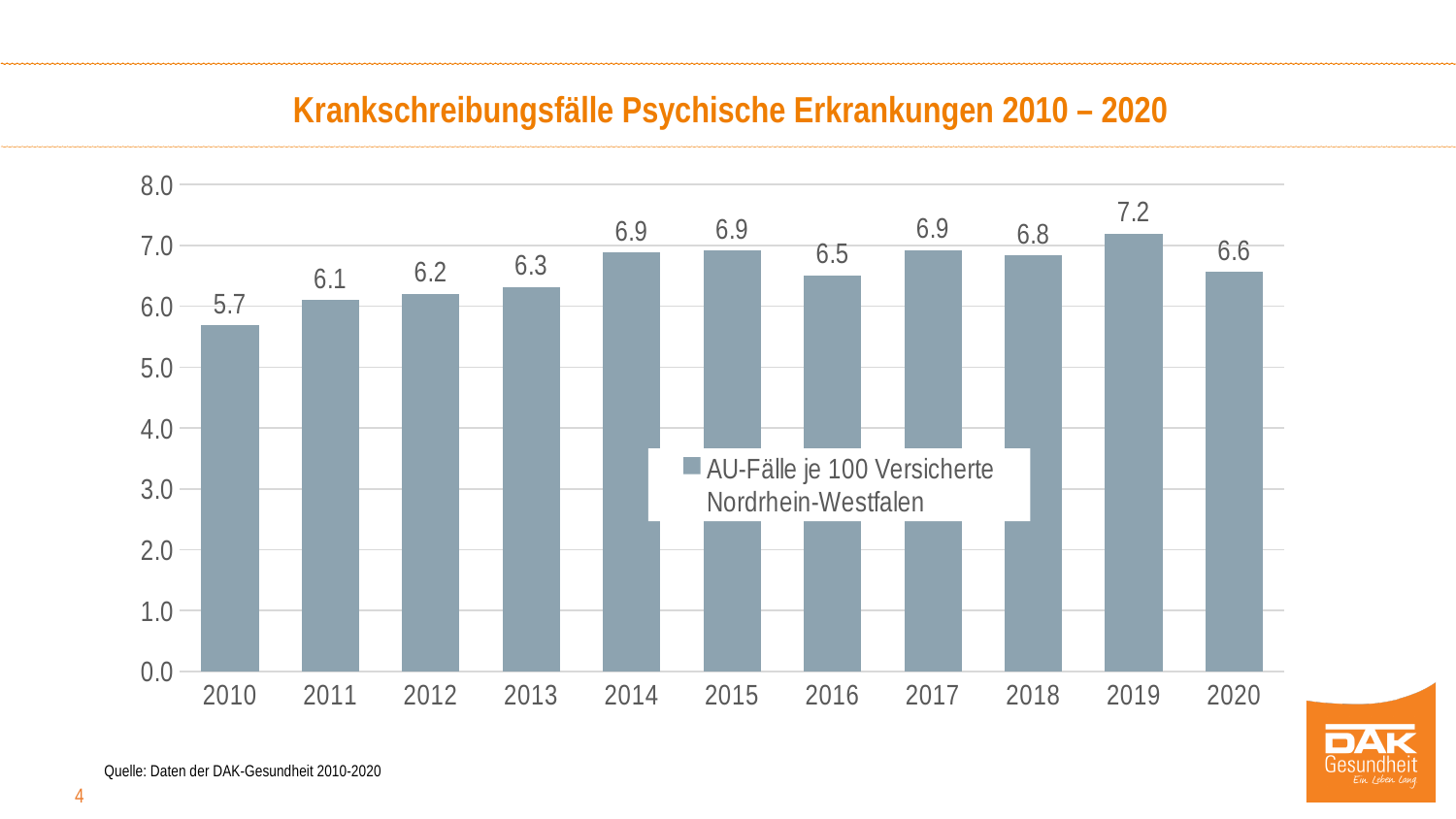
Which year has the highest value? 2019 What is the value for 2016? 6.5 How many years are shown on the x axis? 11 Is the value for 2013 greater or less than 7.0? less What is the value for 2019? 7.2 Which is larger, the value for 2018 or the value for 2020? 2018 What is the value for 2010? 5.7 What is the difference between the values for 2019 and 2010? 1.5 How many series does the legend list? 1 What is the title of the chart? Krankschreibungsfälle Psychische Erkrankungen 2010 – 2020 What kind of chart is shown? bar chart Which year has the lowest value? 2010